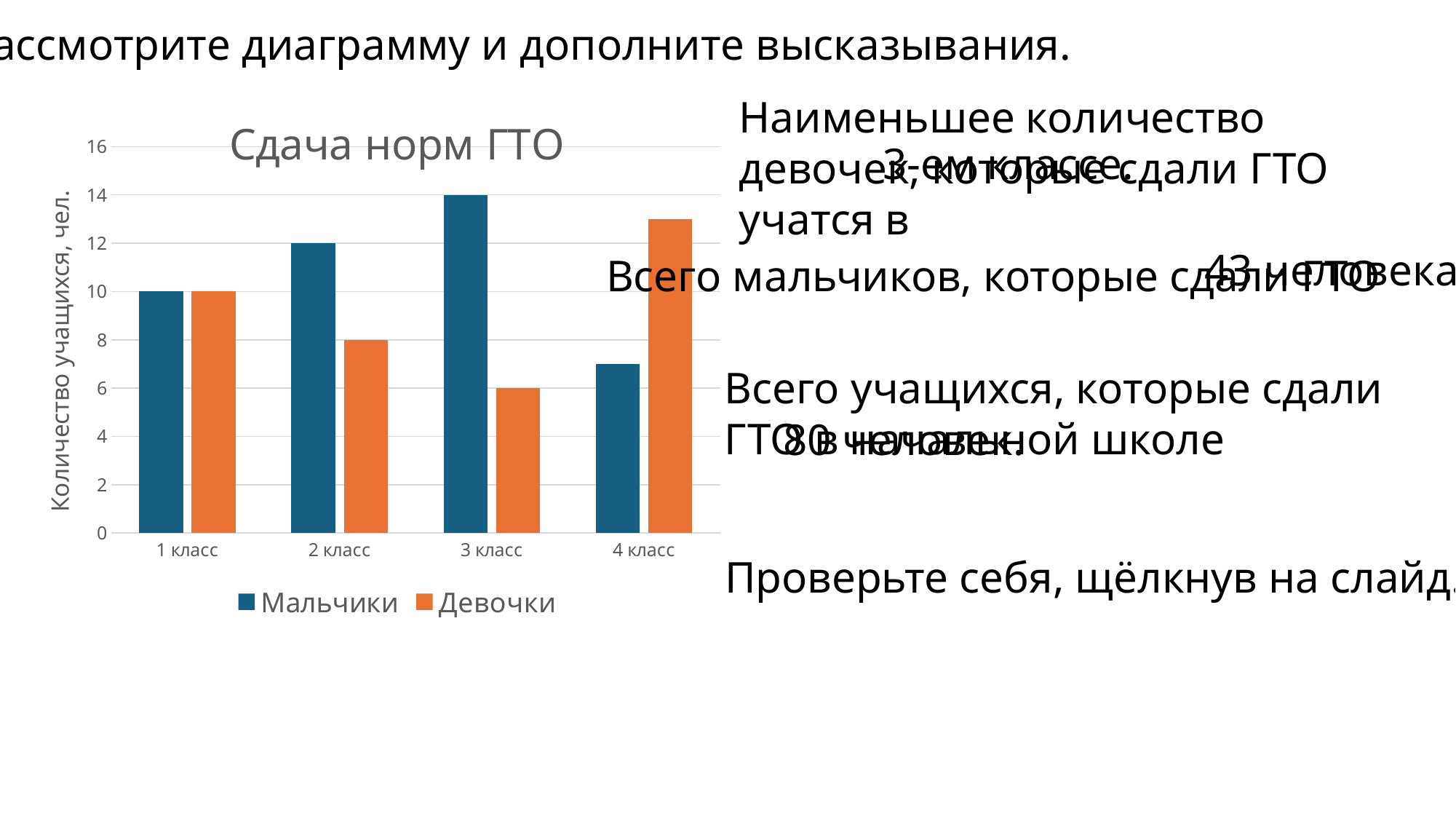
What is the value for Девочки in 2 класс? 8 What is the value for Мальчики in 3 класс? 14 Which is larger in 2 класс, Мальчики or Девочки? Мальчики Is the value for Девочки in 4 класс greater or less than 12? greater What is the value for Девочки in 3 класс? 6 What is the difference between Мальчики and Девочки in 3 класс? 8 In which class is the value for Мальчики the highest? 3 класс What is the title of the chart? Сдача норм ГТО What type of chart is shown on the slide? Bar chart How many series does the legend list? 2 In which class is the value for Девочки the lowest? 3 класс How many classes (categories) are shown on the x axis? 4